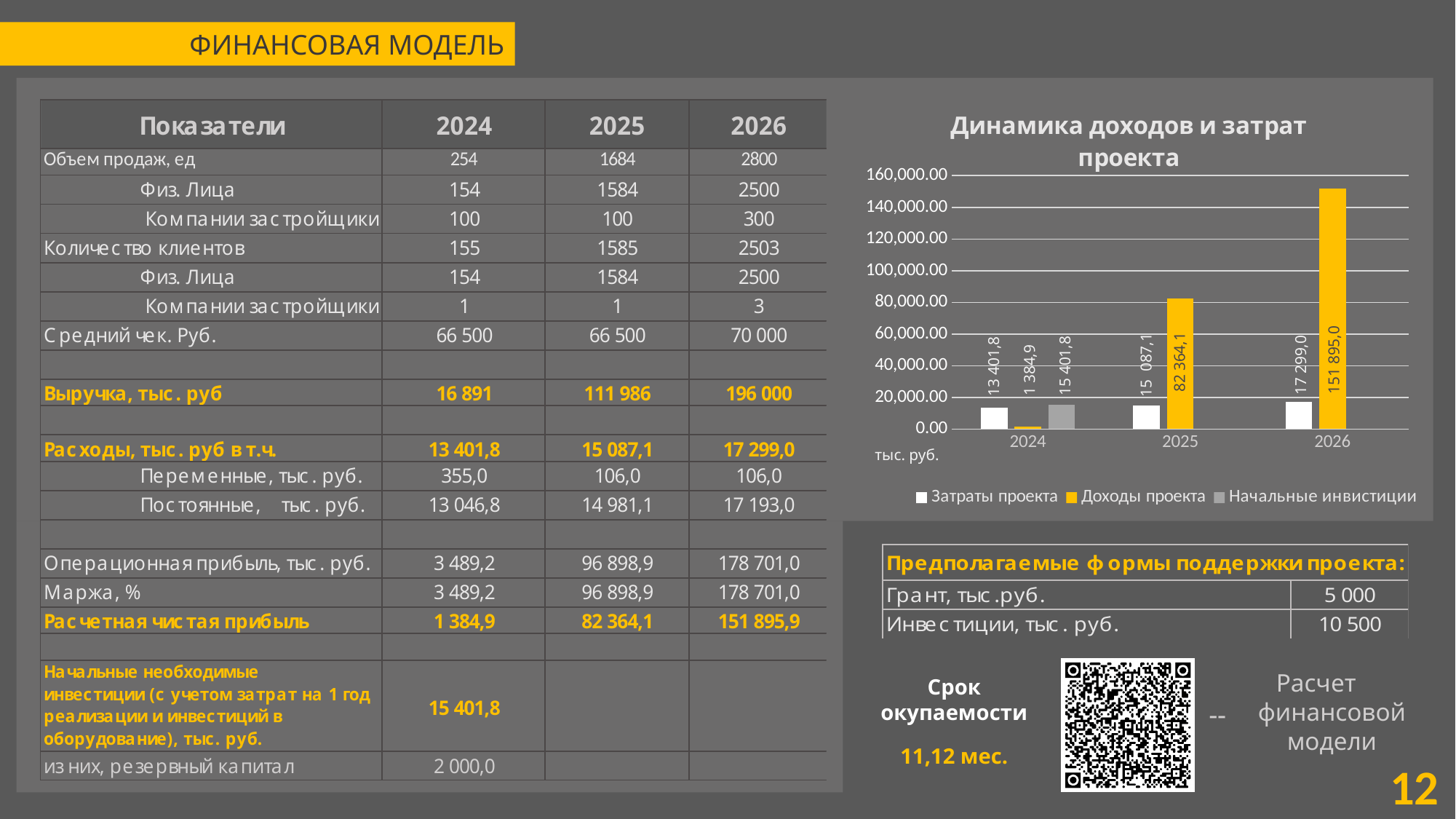
How many years are shown on the x axis of the chart "Динамика доходов и затрат проекта"? 3 How many series does the legend of the chart "Динамика доходов и затрат проекта" list? 3 In the chart "Динамика доходов и затрат проекта", what is the value of Доходы проекта for 2025? 82 364,1 In the chart "Динамика доходов и затрат проекта", which is larger in 2024: Затраты проекта or Доходы проекта? Затраты проекта In the chart "Динамика доходов и затрат проекта", what is the value of Начальные инвистиции for 2024? 15 401,8 In the chart "Динамика доходов и затрат проекта", what is the value of Затраты проекта for 2024? 13 401,8 In the chart "Динамика доходов и затрат проекта", is the value of Доходы проекта for 2026 greater or less than 140,000.00? greater What type of chart is "Динамика доходов и затрат проекта"? bar chart In the chart "Динамика доходов и затрат проекта", do the values of Доходы проекта rise or fall from 2024 to 2026? rise In the chart "Динамика доходов и затрат проекта", which year has the highest value of Доходы проекта? 2026 In the chart "Динамика доходов и затрат проекта", which year has the lowest value of Затраты проекта? 2024 In the chart "Динамика доходов и затрат проекта", what is the difference between Затраты проекта in 2026 and in 2025? 2 211,9